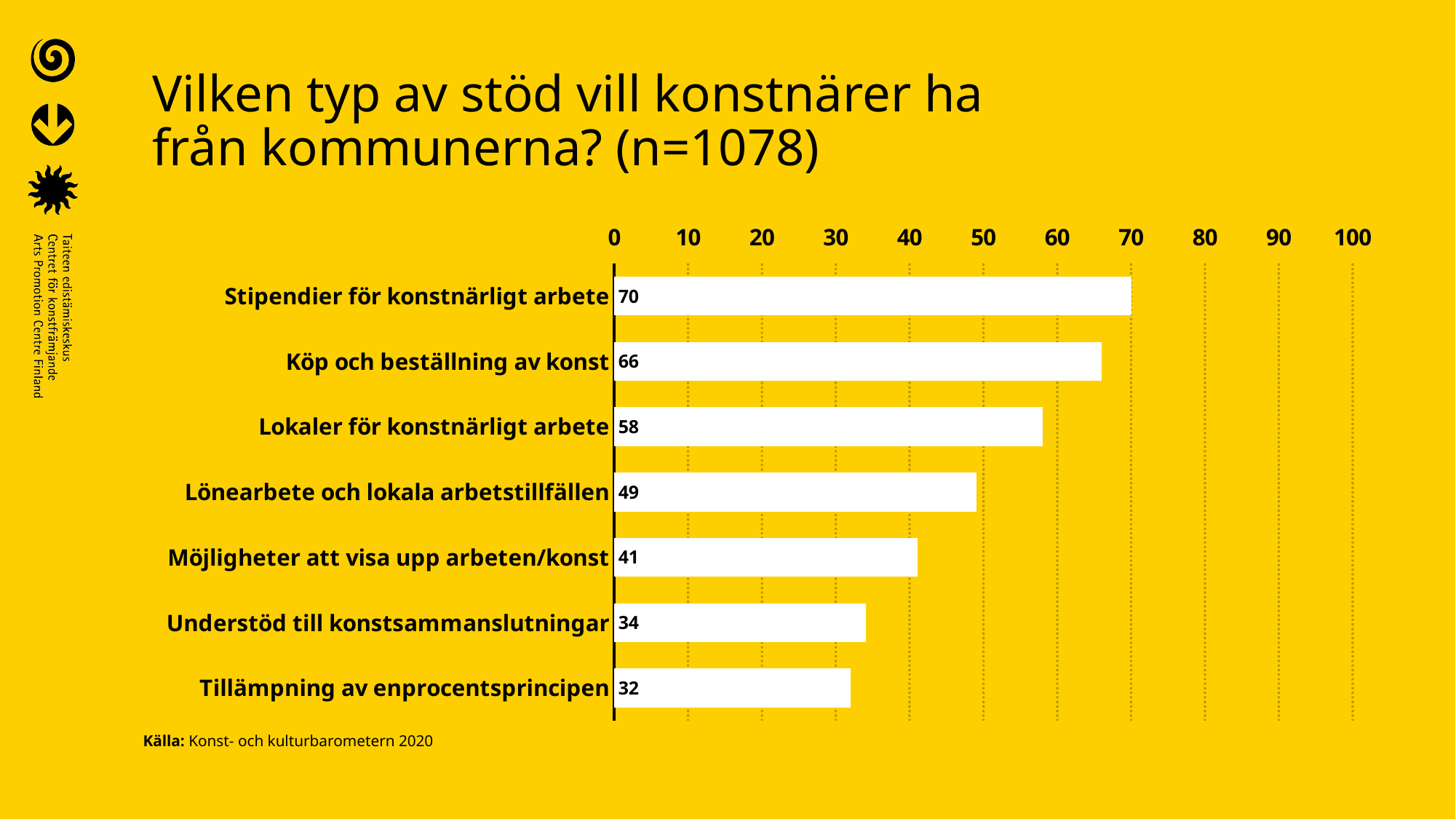
Is the value for "Köp och beställning av konst" greater or less than 60? greater What is the value for "Lokaler för konstnärligt arbete"? 58 What is the highest value shown on the chart's axis? 100 What is the difference between the values for "Köp och beställning av konst" and "Möjligheter att visa upp arbeten/konst"? 25 What source is cited below the chart? Konst- och kulturbarometern 2020 What kind of chart is shown on the slide? bar chart Which category has the highest value? Stipendier för konstnärligt arbete Which category has the lowest value? Tillämpning av enprocentsprincipen How many categories are shown in the chart? 7 What is the value for "Stipendier för konstnärligt arbete"? 70 Which is larger: the value for "Lönearbete och lokala arbetstillfällen" or the value for "Understöd till konstsammanslutningar"? Lönearbete och lokala arbetstillfällen What is the value for "Understöd till konstsammanslutningar"? 34